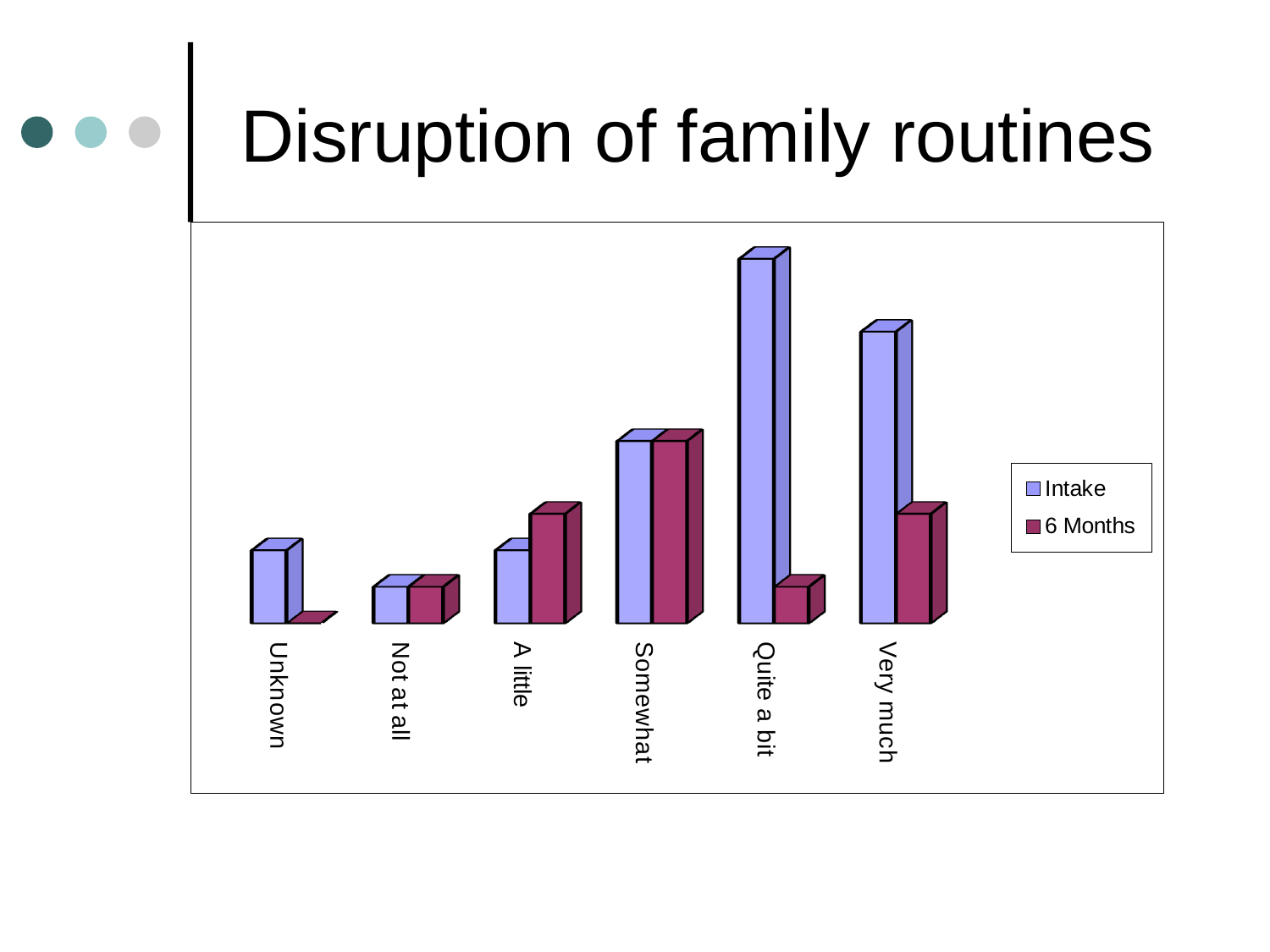
For the category Quite a bit, which series has the larger value, Intake or 6 Months? Intake Which category has the lowest Intake value? Not at all How many categories are shown on the x axis of the chart? 6 For the category A little, which series has the larger value, Intake or 6 Months? 6 Months Which category has the highest Intake value? Quite a bit What are the two series named in the chart's legend? Intake and 6 Months What is the title of the slide containing the chart? Disruption of family routines What kind of chart is shown on the slide? bar chart For the category Very much, which series has the larger value, Intake or 6 Months? Intake Which category has the lowest 6 Months value? Unknown Which category has the highest 6 Months value? Somewhat How many series does the chart's legend list? 2